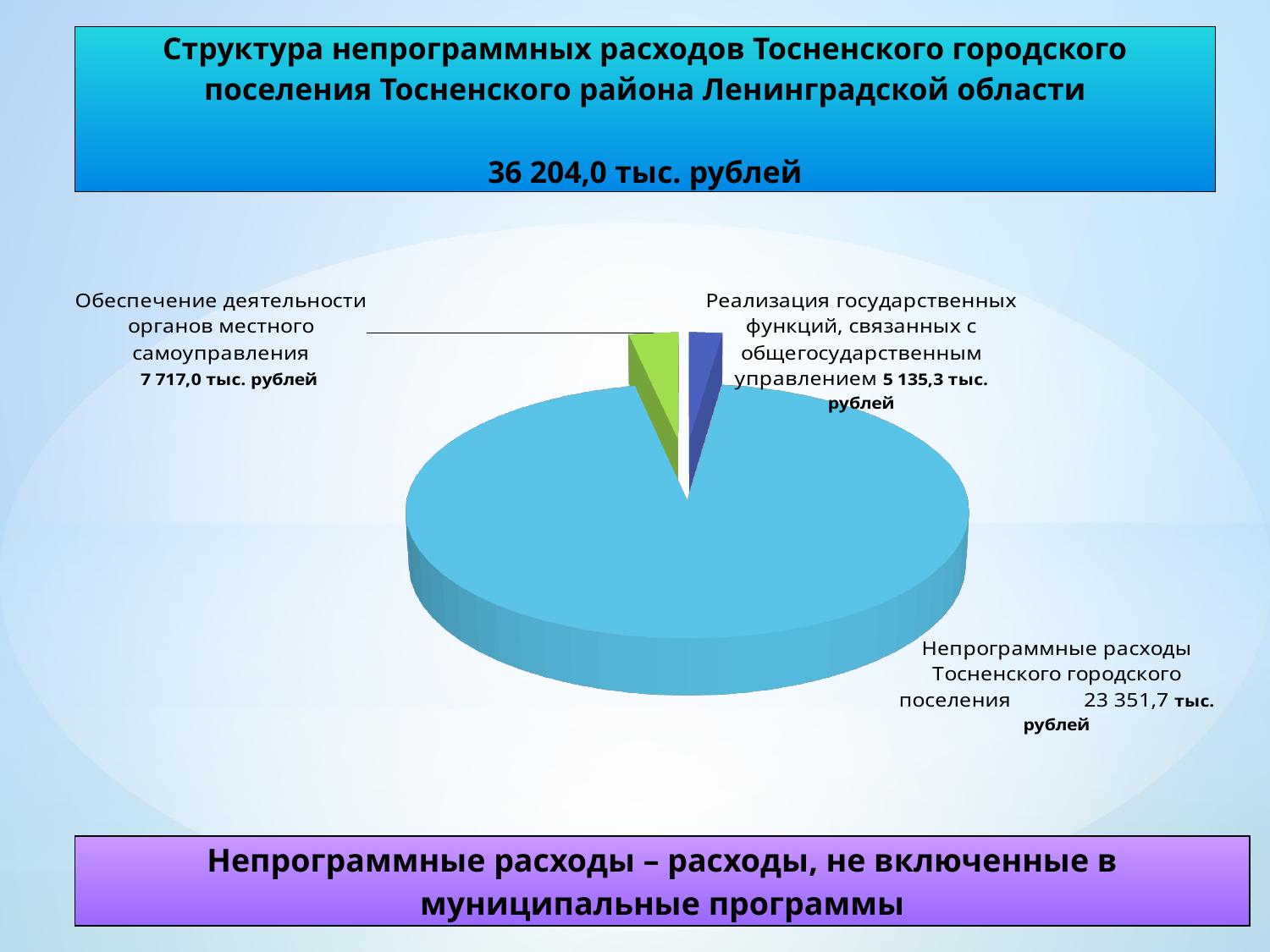
What is the difference between "Непрограммные расходы Тосненского городского поселения" and "Обеспечение деятельности органов местного самоуправления"? 15 634,7 тыс. рублей What is the difference between "Обеспечение деятельности органов местного самоуправления" and "Реализация государственных функций, связанных с общегосударственным управлением"? 2 581,7 тыс. рублей What total amount is stated in the chart title? 36 204,0 тыс. рублей Which is larger: "Обеспечение деятельности органов местного самоуправления" or "Реализация государственных функций, связанных с общегосударственным управлением"? Обеспечение деятельности органов местного самоуправления What colour is the largest slice of the pie? Light blue What is the value for "Непрограммные расходы Тосненского городского поселения"? 23 351,7 тыс. рублей Which category has the smallest slice of the pie? Реализация государственных функций, связанных с общегосударственным управлением How many slices does the pie chart have? 3 Which category has the largest slice of the pie? Непрограммные расходы Тосненского городского поселения What is the value for "Реализация государственных функций, связанных с общегосударственным управлением"? 5 135,3 тыс. рублей What type of chart is shown on the slide? Pie chart What is the value for "Обеспечение деятельности органов местного самоуправления"? 7 717,0 тыс. рублей